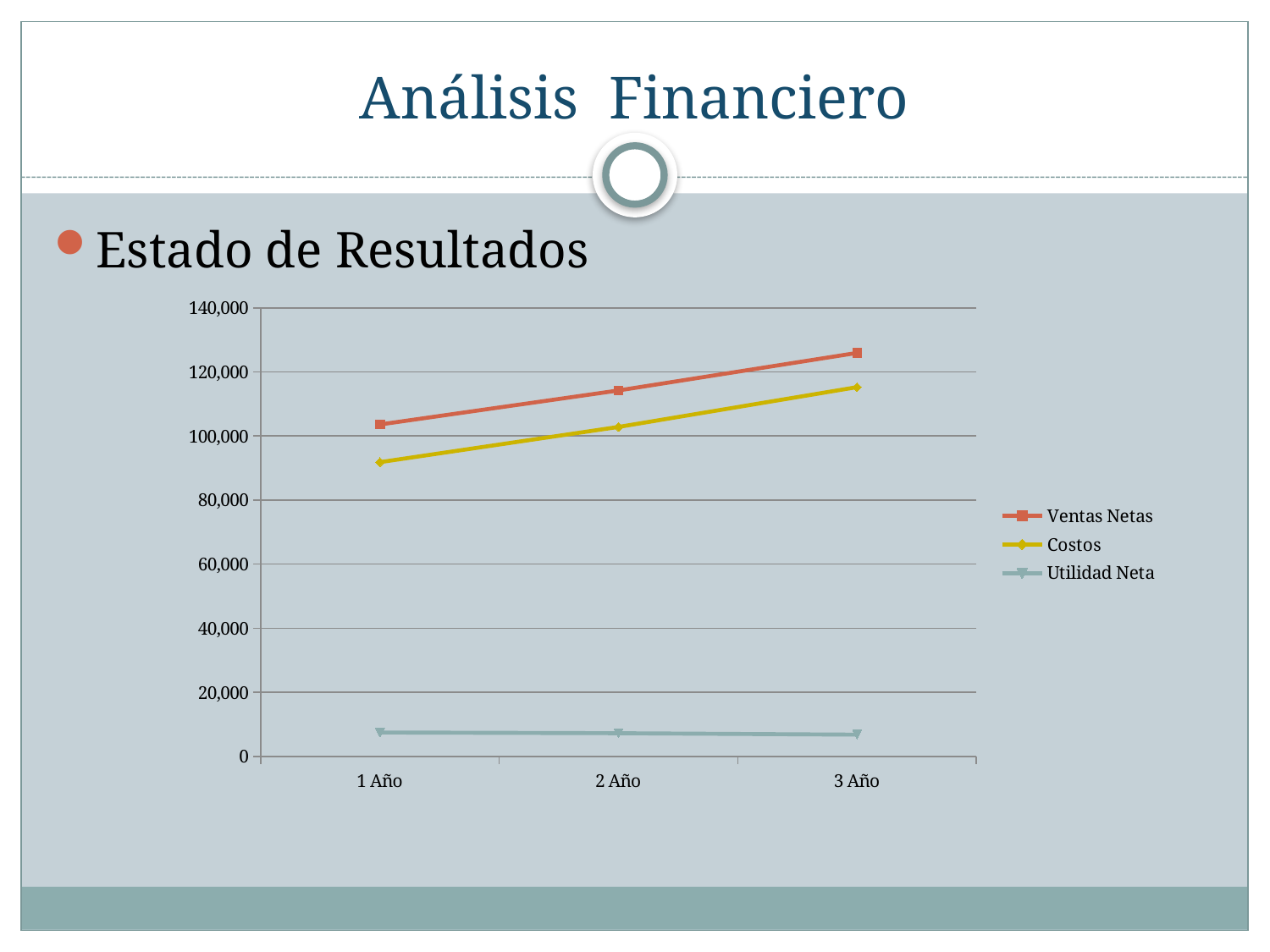
How many categories are shown on the x axis? 3 Is the value for Utilidad Neta in 2 Año greater or less than 20,000? less Which series has the lowest values across all three years? Utilidad Neta What kind of chart is shown on the slide? line chart Which is larger in 2 Año, Ventas Netas or Costos? Ventas Netas How many series does the legend list? 3 Do the values for Costos rise or fall from 1 Año to 3 Año? rise In which year is Ventas Netas highest? 3 Año Is the value for Costos in 1 Año greater or less than 100,000? less Which series is plotted with the red line? Ventas Netas Is the value for Ventas Netas in 3 Año greater or less than 120,000? greater Do the values for Ventas Netas rise or fall from 1 Año to 3 Año? rise